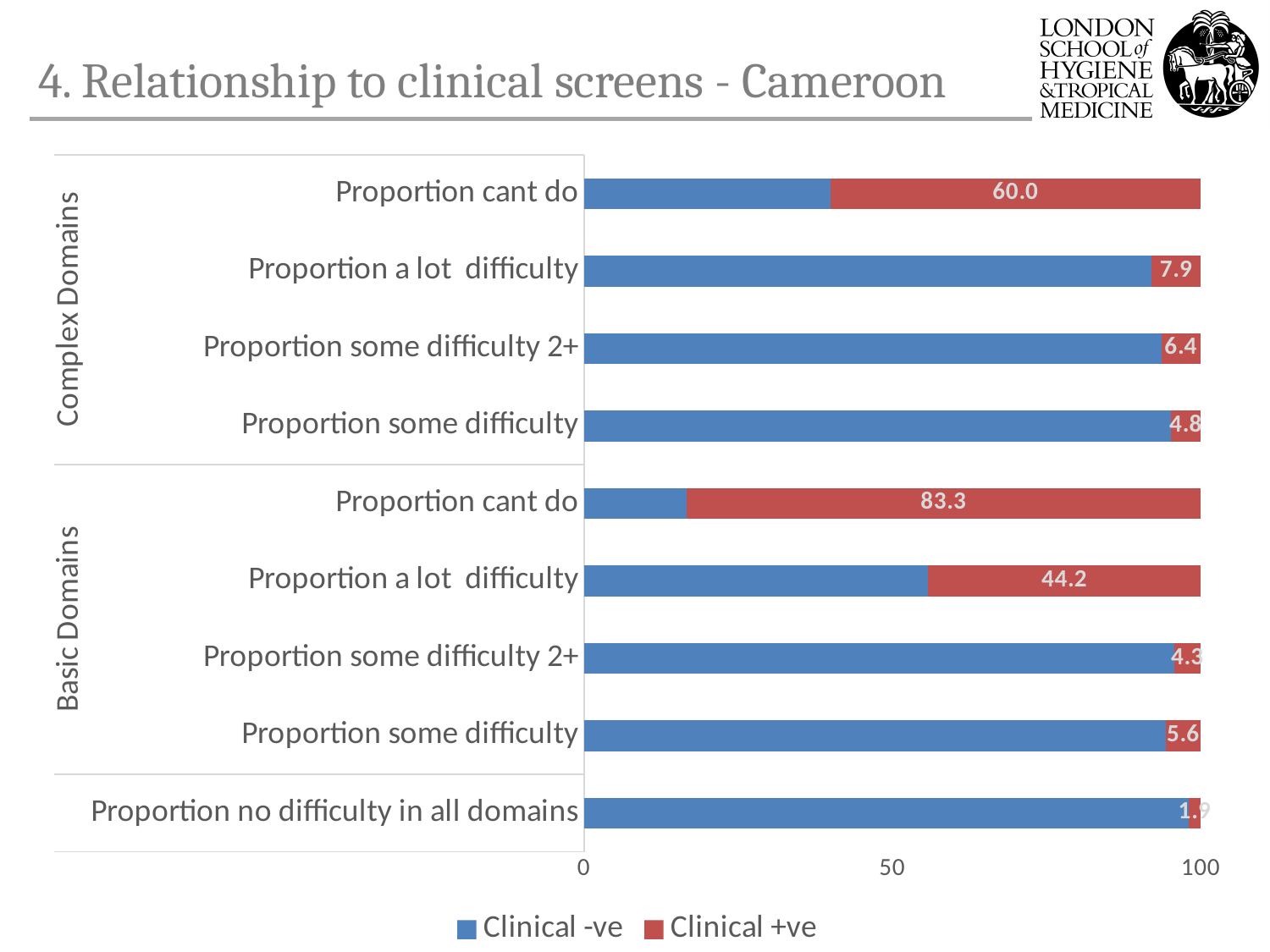
What is the Clinical +ve value for 'Proportion some difficulty' in the Complex Domains group? 4.8 What is the Clinical +ve value for 'Proportion a lot difficulty' in the Basic Domains group? 44.2 How many bars (categories) are plotted in the chart? 9 What kind of chart is shown on the slide? Stacked bar chart Which category has the highest Clinical +ve value? Proportion cant do (Basic Domains) In the Complex Domains group, which has the larger Clinical +ve value: 'Proportion a lot difficulty' or 'Proportion some difficulty 2+'? Proportion a lot difficulty What is the Clinical +ve value for 'Proportion cant do' in the Complex Domains group? 60.0 What are the two series named in the legend? Clinical -ve and Clinical +ve Is the Clinical -ve value for 'Proportion cant do' in the Basic Domains group greater or less than 50? less What is the Clinical +ve value for 'Proportion cant do' in the Basic Domains group? 83.3 What is the difference between the Clinical +ve values for 'Proportion cant do' in the Basic Domains group and in the Complex Domains group? 23.3 How many series does the legend list? 2